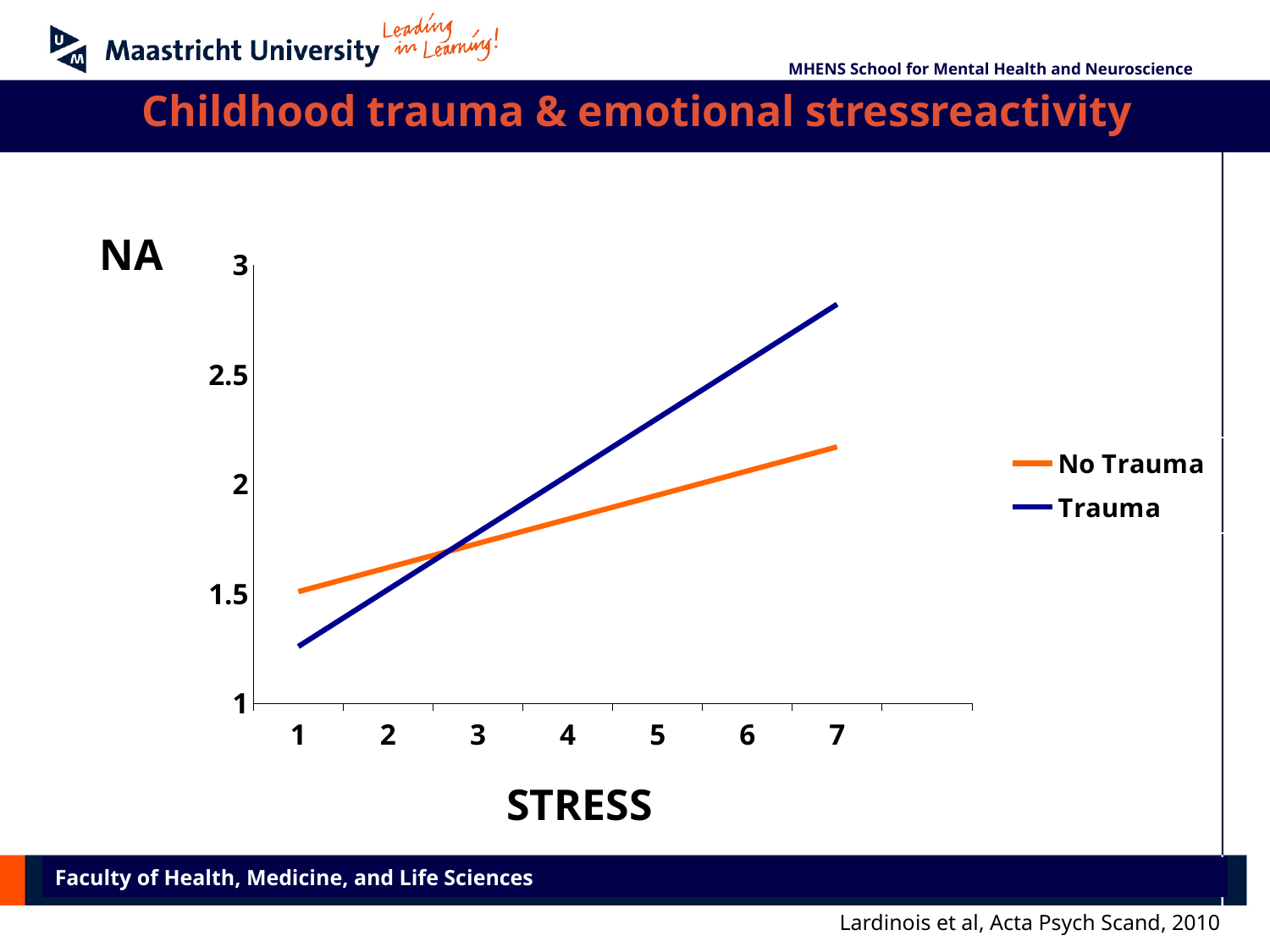
At STRESS level 7, which series has the higher NA value, Trauma or No Trauma? Trauma Does the No Trauma line rise or fall as STRESS increases from 1 to 7? rise Is the NA value for No Trauma at STRESS level 7 greater or less than 2? greater Is the NA value for Trauma at STRESS level 7 greater or less than 2.5? greater How many series does the legend list? 2 Is the NA value for Trauma at STRESS level 1 greater or less than 1.5? less What kind of chart is shown on the slide? line chart At STRESS level 1, which series has the higher NA value, Trauma or No Trauma? No Trauma Which series does the legend list besides Trauma? No Trauma Does the Trauma line rise or fall as STRESS increases from 1 to 7? rise What is the label on the x axis of the chart? STRESS